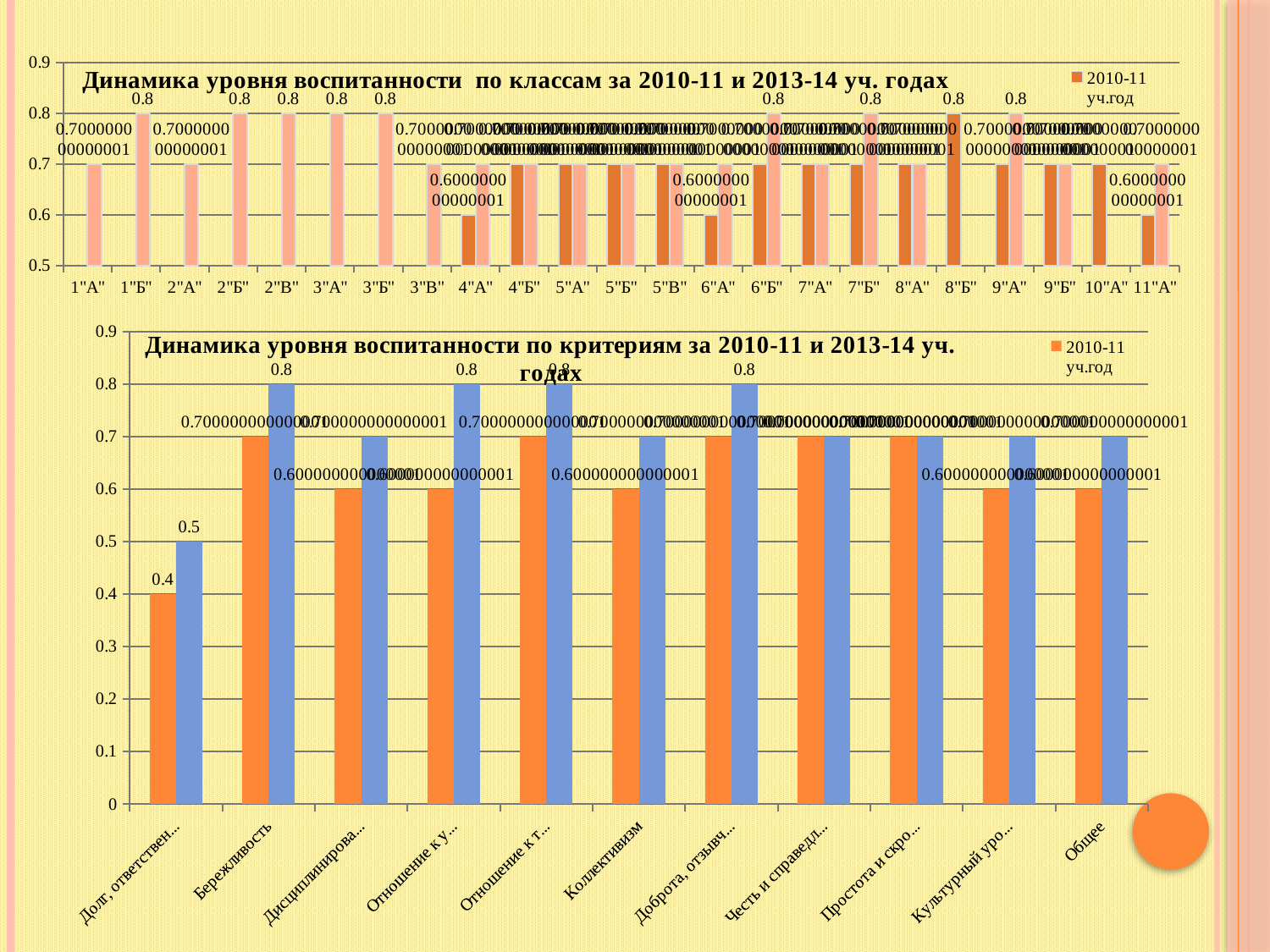
In the top chart (по классам), how many classes are listed on the x axis? 23 In the bottom chart (по критериям), which has the larger 2010-11 уч.год value: 'Бережливость' or 'Долг, ответствен...'? Бережливость In the bottom chart (по критериям), what is the 2010-11 уч.год value for 'Долг, ответствен...'? 0.4 In the bottom chart (по критериям), is the 2010-11 уч.год value for 'Коллективизм' greater or less than 0.5? greater In the bottom chart (по критериям), how many criteria categories are shown on the x axis? 11 In the bottom chart (по критериям), what is the value of the blue bar for 'Долг, ответствен...'? 0.5 In the bottom chart (по критериям), which criterion has the lowest 2010-11 уч.год value? Долг, ответствен... In the top chart (по классам), what is the value of the bar for class 1"Б"? 0.8 In the bottom chart (по критериям), what is the value of the blue bar for 'Бережливость'? 0.8 In the bottom chart (по критериям), what is the difference between the blue bar and the 2010-11 уч.год bar for 'Долг, ответствен...'? 0.1 What kind of chart is the top chart, 'Динамика уровня воспитанности по классам за 2010-11 и 2013-14 уч. годах'? bar chart What kind of chart is the bottom chart, 'Динамика уровня воспитанности по критериям за 2010-11 и 2013-14 уч. годах'? bar chart